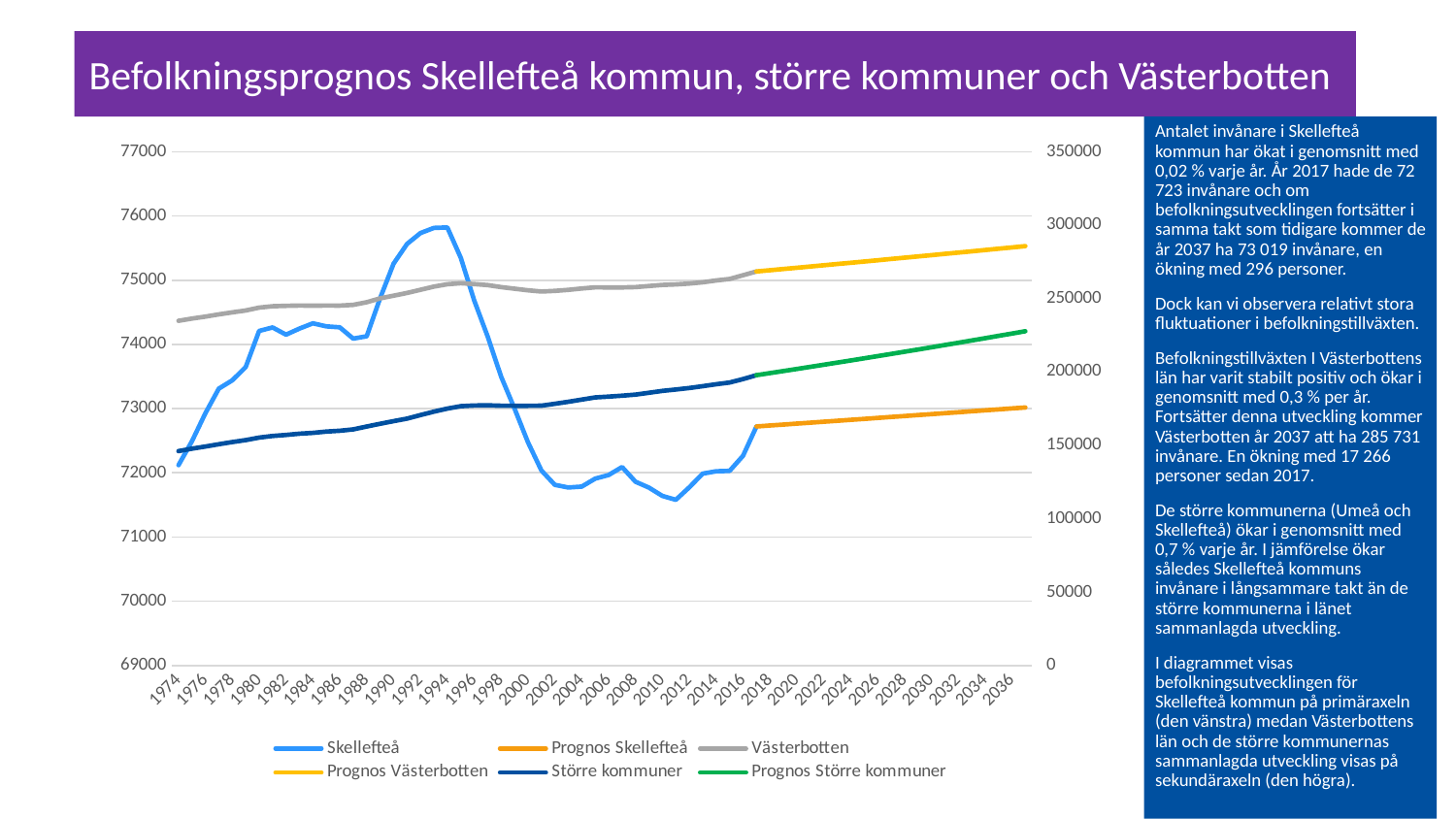
Is the value for Västerbotten in 1974 greater or less than 200000 on the right axis? greater Is the value for Skellefteå in 2012 greater or less than 72000? less What kind of chart is shown on the slide? line chart Which is larger, the Skellefteå value in 1994 or in 2012? 1994 In which year is the Skellefteå line at its lowest? 2011 How many series does the legend list? 6 What colour is the Prognos Skellefteå line? orange Is the value for Skellefteå in 1974 greater or less than 73000? less Does the Prognos Västerbotten line rise or fall from 2018 to 2036? rise What is the title of the chart? Befolkningsprognos Skellefteå kommun, större kommuner och Västerbotten